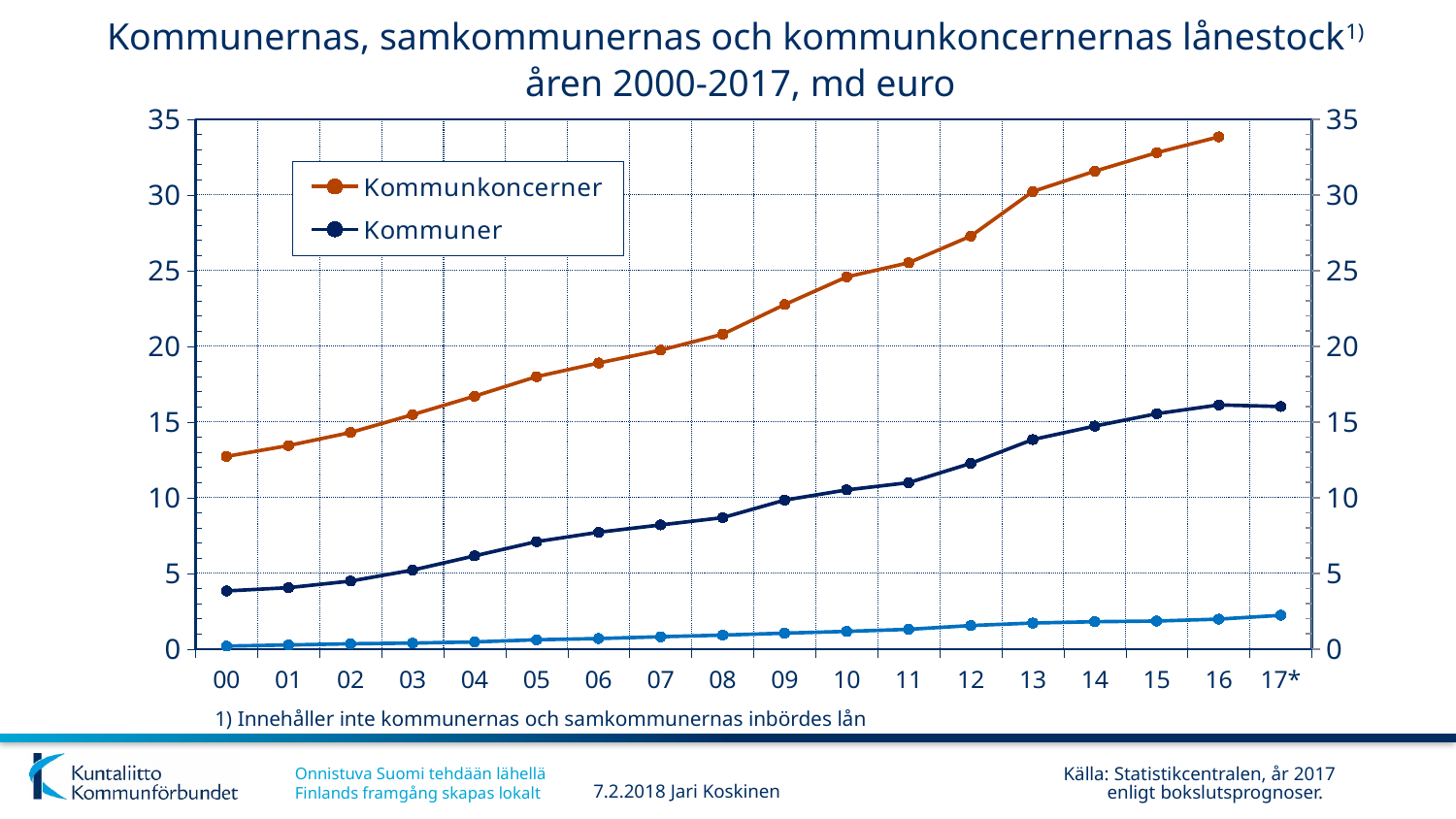
Is the Kommunkoncerner value for 16 greater or less than 30? greater Is the Kommunkoncerner value for 00 greater or less than 10? greater In 10, which is larger: Kommunkoncerner or Kommuner? Kommunkoncerner Is the Kommuner value for 13 greater or less than 15? less In which year is the Kommunkoncerner value lowest? 00 In which year is the Kommunkoncerner value highest? 16 How many years are shown along the x axis? 18 Which series does the legend list first? Kommunkoncerner What kind of chart is shown on the slide? Line chart Does the Kommunkoncerner line rise or fall from 00 to 17*? Rises How many series does the legend list? 2